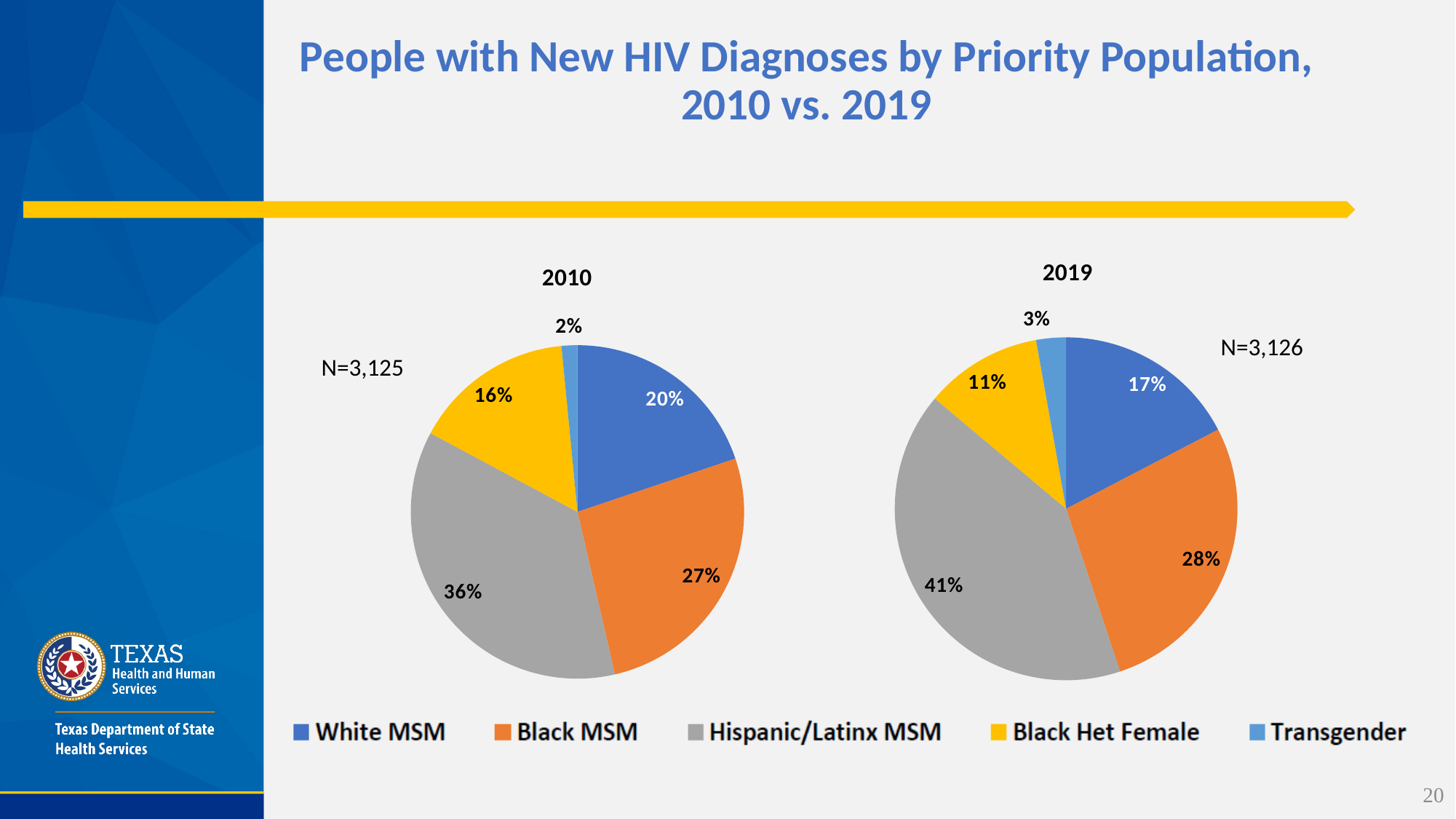
What type of chart is used on this slide? Pie chart Is the White MSM share larger in the 2010 pie chart or the 2019 pie chart? 2010 In the 2010 pie chart, what percentage is shown for Black Het Female? 16% In the 2019 pie chart, what share of new HIV diagnoses is Black MSM? 28% In the 2019 pie chart, what percentage is shown for Transgender? 3% In the 2010 pie chart, what share of new HIV diagnoses is Hispanic/Latinx MSM? 36% In the 2019 pie chart, which priority population has the largest share? Hispanic/Latinx MSM In the 2010 pie chart, which priority population has the smallest share? Transgender Which colour represents Black Het Female in the legend? Yellow What is the difference in percentage points between the Hispanic/Latinx MSM share in 2019 and in 2010? 5 How many priority populations are shown in each pie chart? 5 What is the N value shown for the 2019 pie chart? N=3,126